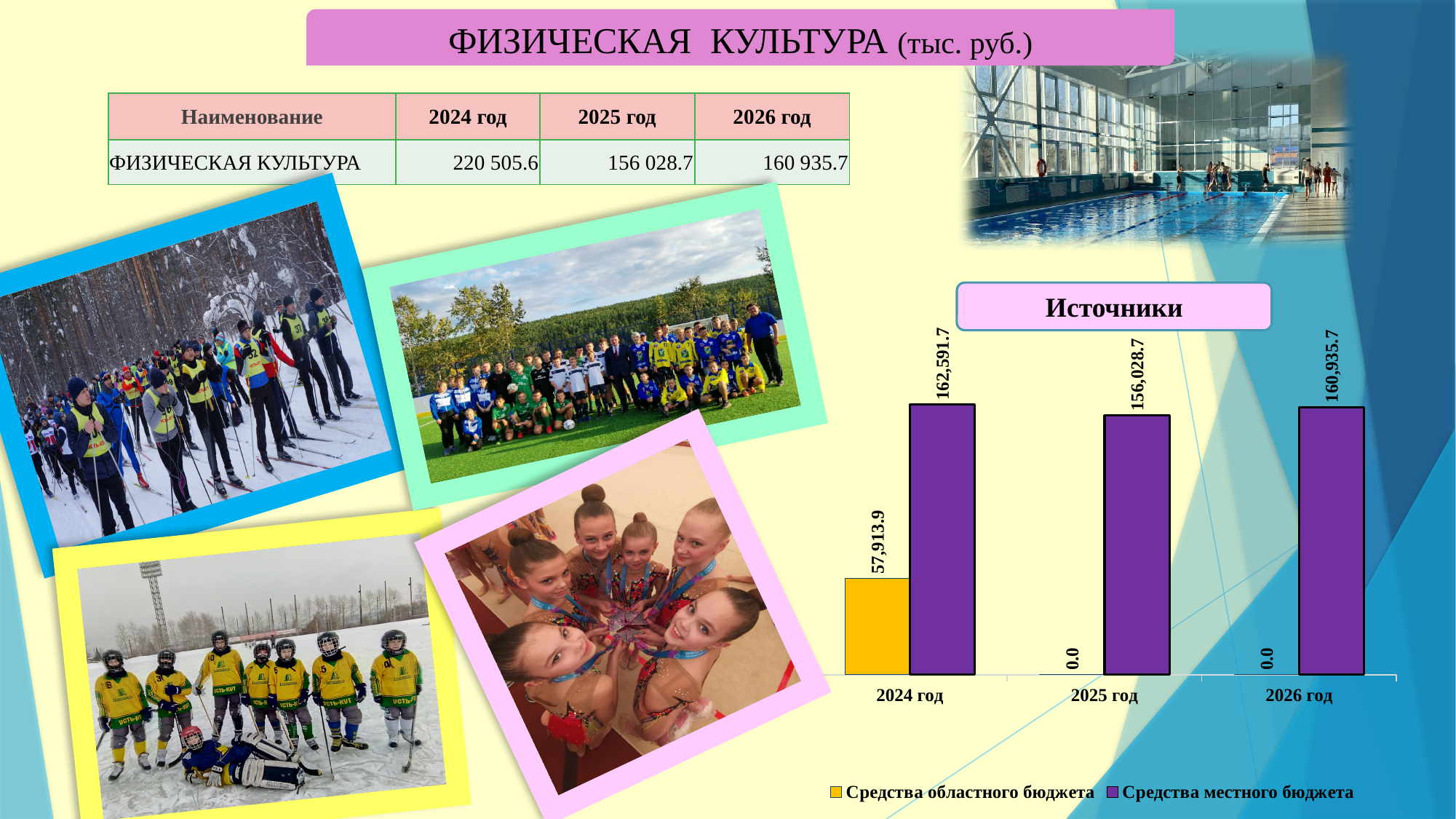
In which year is Средства местного бюджета highest? 2024 год What kind of chart is shown under the heading Источники? bar chart What is the value for Средства областного бюджета in 2024 год? 57,913.9 What is the difference between Средства местного бюджета in 2026 год and in 2025 год? 4,907.0 What is the value for Средства местного бюджета in 2024 год? 162,591.7 How many series does the legend list? 2 What is the value for Средства местного бюджета in 2025 год? 156,028.7 Which is larger in 2024 год: Средства областного бюджета or Средства местного бюджета? Средства местного бюджета What is the value for Средства областного бюджета in 2026 год? 0.0 In which year is Средства местного бюджета lowest? 2025 год What is the difference between Средства местного бюджета and Средства областного бюджета in 2024 год? 104,677.8 What is the value for Средства местного бюджета in 2026 год? 160,935.7